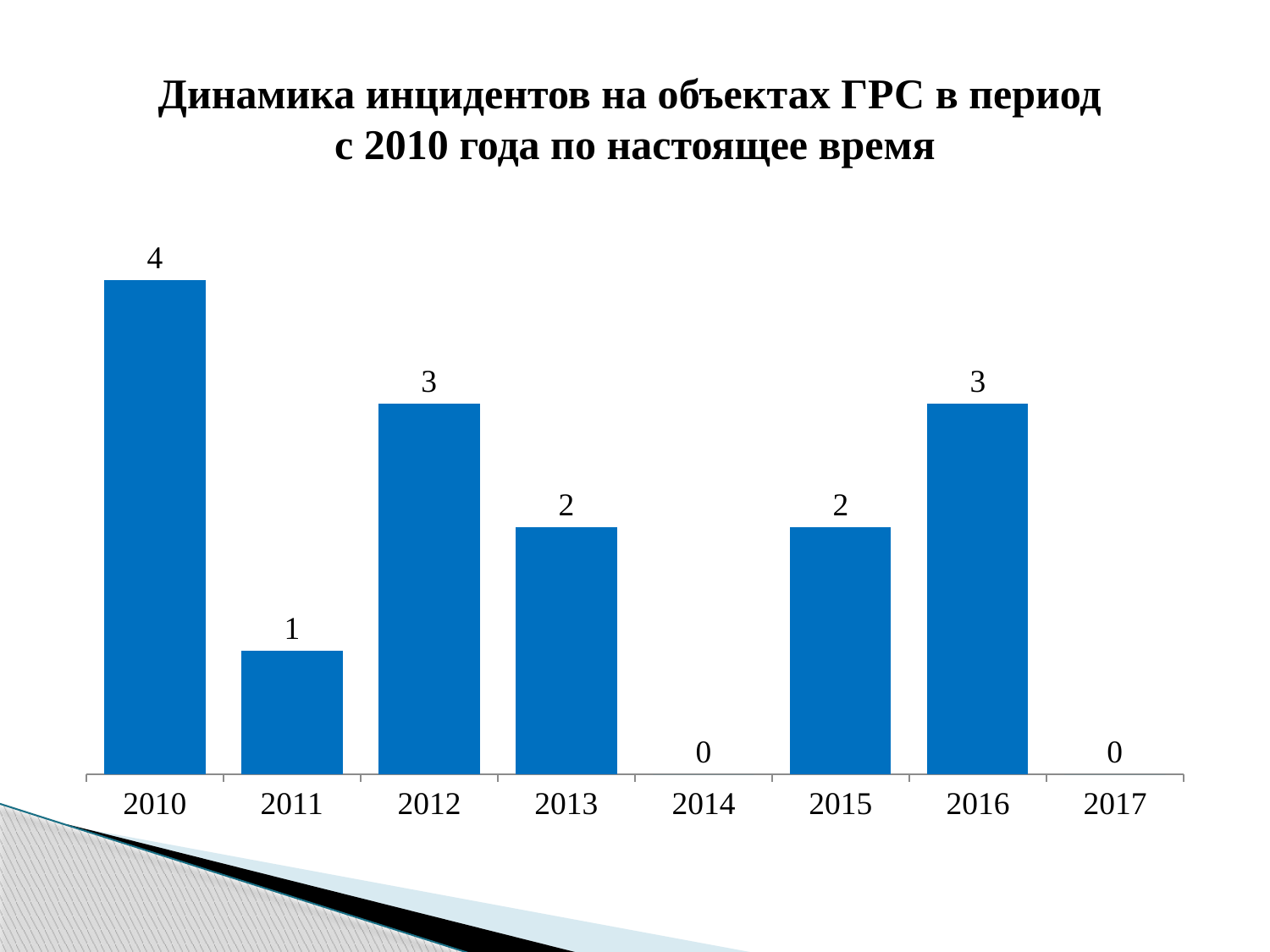
What is the value for 2015? 2 How many years are shown on the x axis? 8 Which years have a value of 0? 2014 and 2017 Which is larger, the value for 2012 or the value for 2015? 2012 Which year has the highest value? 2010 What kind of chart is shown on the slide? bar chart What is the difference between the values for 2010 and 2013? 2 What is the difference between the values for 2012 and 2011? 2 What is the value for 2010? 4 What is the title of the chart? Динамика инцидентов на объектах ГРС в период с 2010 года по настоящее время What is the value for 2011? 1 What is the value for 2016? 3